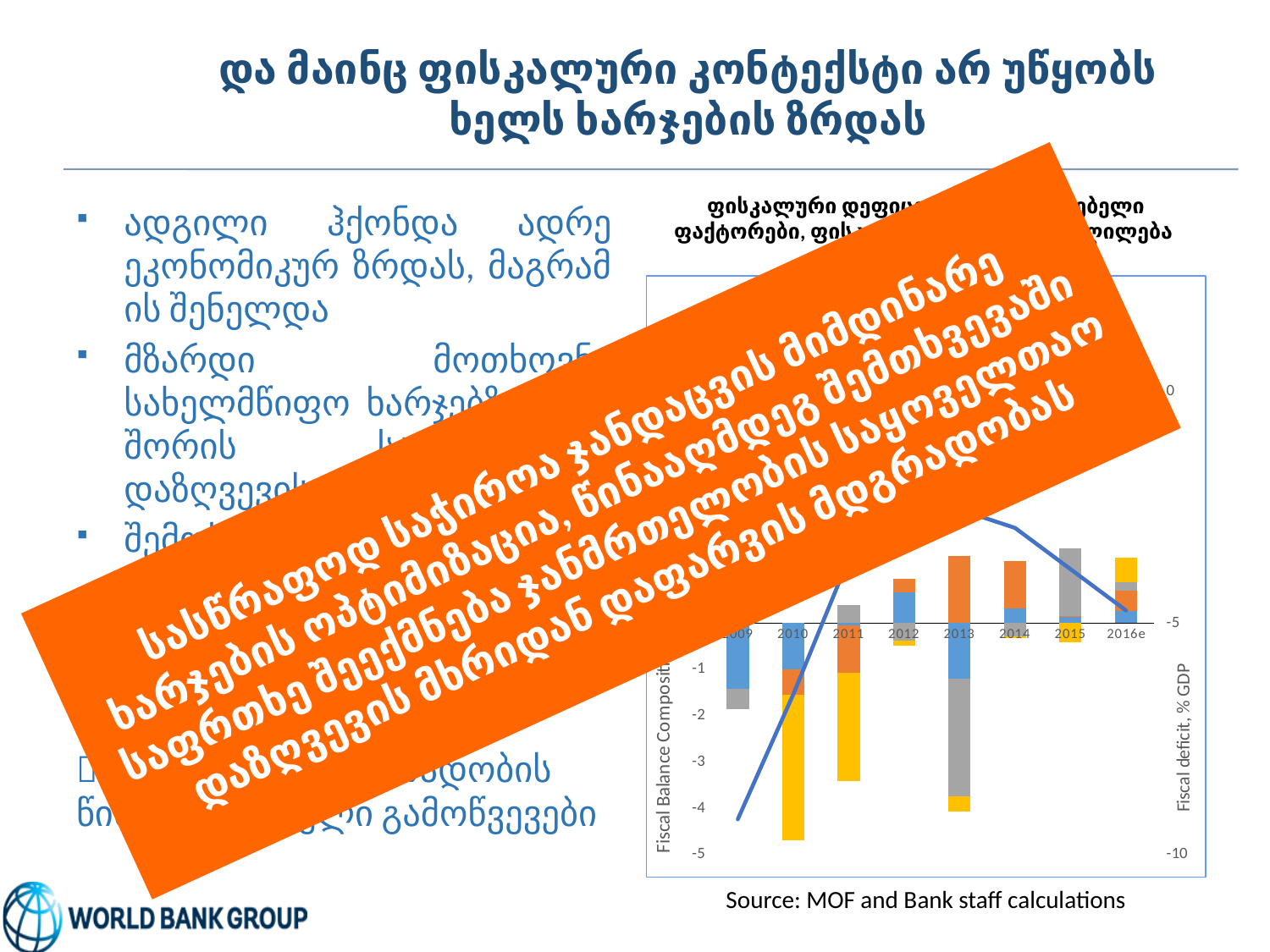
What source is cited below the chart? MOF and Bank staff calculations What kind of chart is shown on the right of the slide? A stacked bar chart with a line What is the lowest tick value shown on the right vertical axis of the chart? -10 What is the last category shown on the x axis of the chart? 2016e Is the bottom of the stacked bar for 2010 greater or less than -4 on the left axis? less Is the bottom of the stacked bar for 2012 greater or less than -1 on the left axis? greater Does the line in the chart rise or fall between 2015 and 2016e? fall Is the bottom of the stacked bar for 2011 greater or less than -3 on the left axis? less Does the line in the chart rise or fall between 2009 and 2010? rise What is the label of the right-hand vertical axis of the chart? Fiscal deficit, % GDP What is the lowest tick value shown on the left vertical axis of the chart? -5